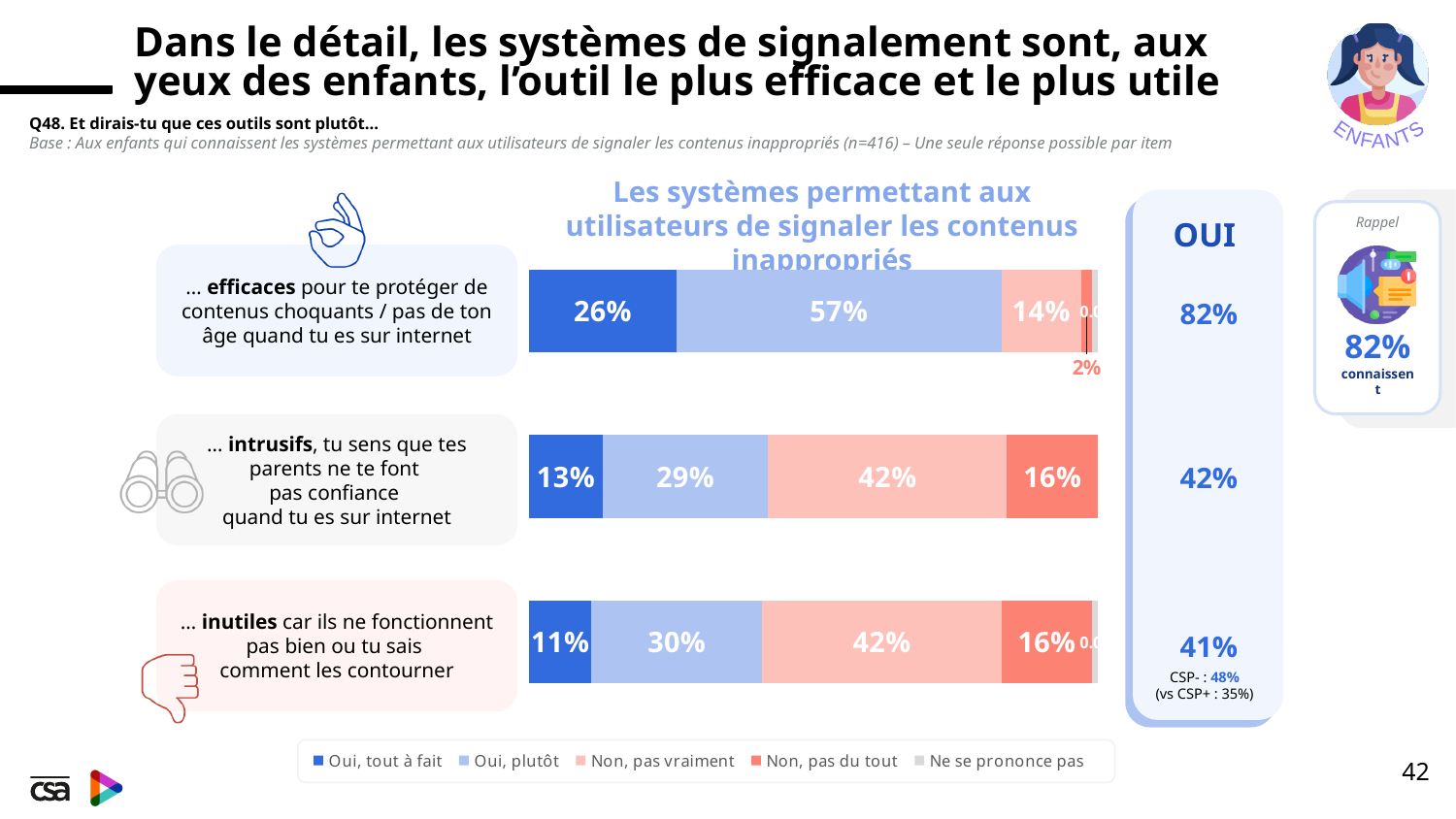
Which is larger: the "Non, pas vraiment" value for "efficaces" or for "inutiles"? inutiles What is the value of "Non, pas du tout" for the item "inutiles"? 16% How many series does the chart legend list? 5 How many items (bars) are plotted in the chart? 3 What is the value of "Oui, plutôt" for the item "efficaces"? 57% What kind of chart is shown on the slide? stacked bar chart What total "OUI" percentage is shown for the item "intrusifs"? 42% Which item has the lowest "Oui, tout à fait" value? inutiles What is the value of "Non, pas vraiment" for the item "intrusifs"? 42% Which item has the highest "Oui, tout à fait" value? efficaces What is the difference between the "Oui, plutôt" values for "efficaces" and "intrusifs"? 28 percentage points What is the value of "Oui, tout à fait" for the item "efficaces"? 26%